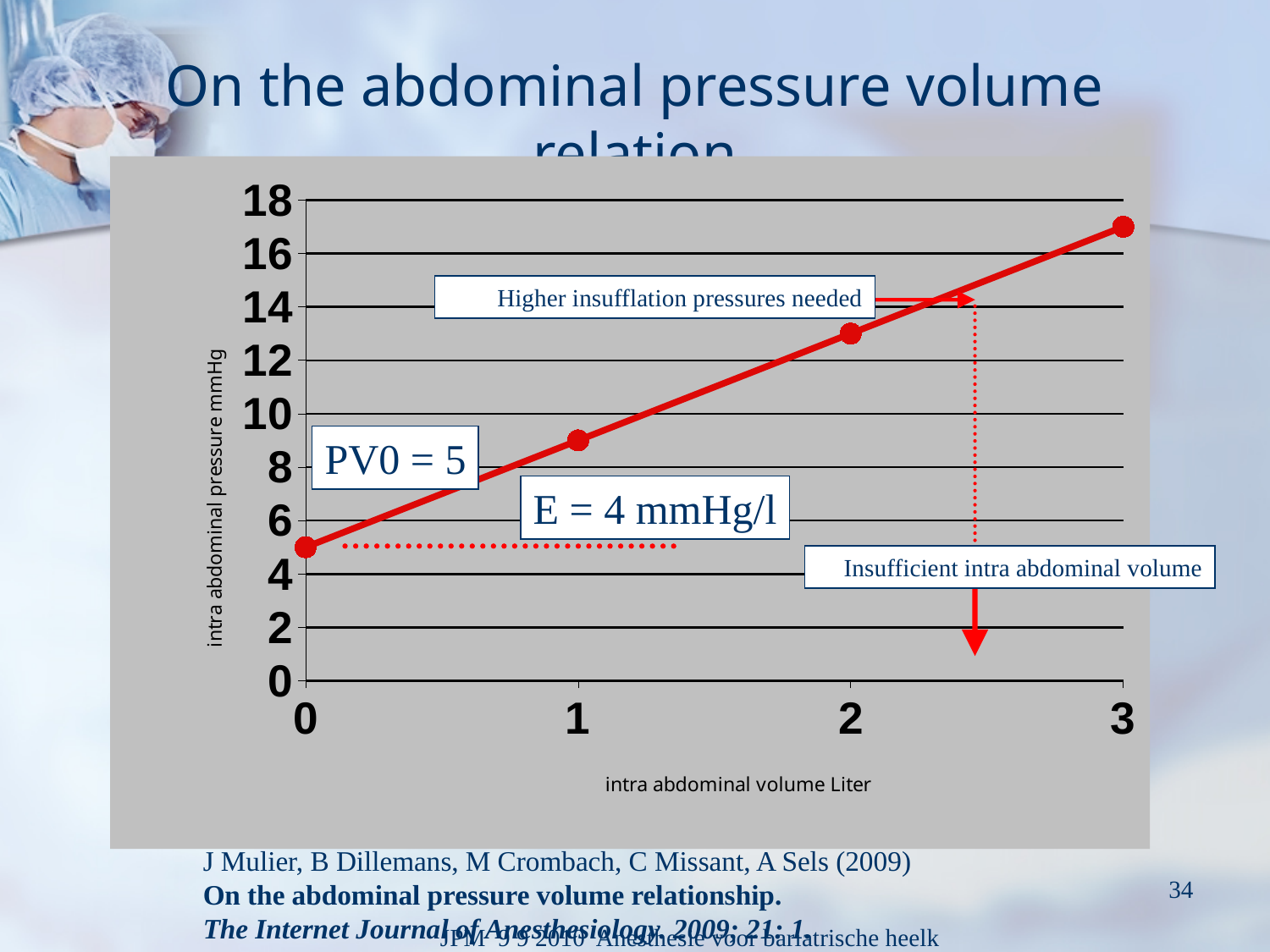
Is the pressure value at 0 liters greater or less than 6? less Which is larger, the pressure at 2 liters or the pressure at 1 liter? 2 liters What is the label of the y axis? intra abdominal pressure mmHg Is the pressure value at 2 liters greater or less than 12? greater What kind of chart is shown on the slide? line chart Is the pressure value at 1 liter greater or less than 10? less Does intra abdominal pressure rise or fall as intra abdominal volume increases along the x axis? rises How many data points are plotted on the line? 4 At which intra abdominal volume is the plotted pressure lowest? 0 At which intra abdominal volume is the plotted pressure highest? 3 What is the label of the x axis? intra abdominal volume Liter